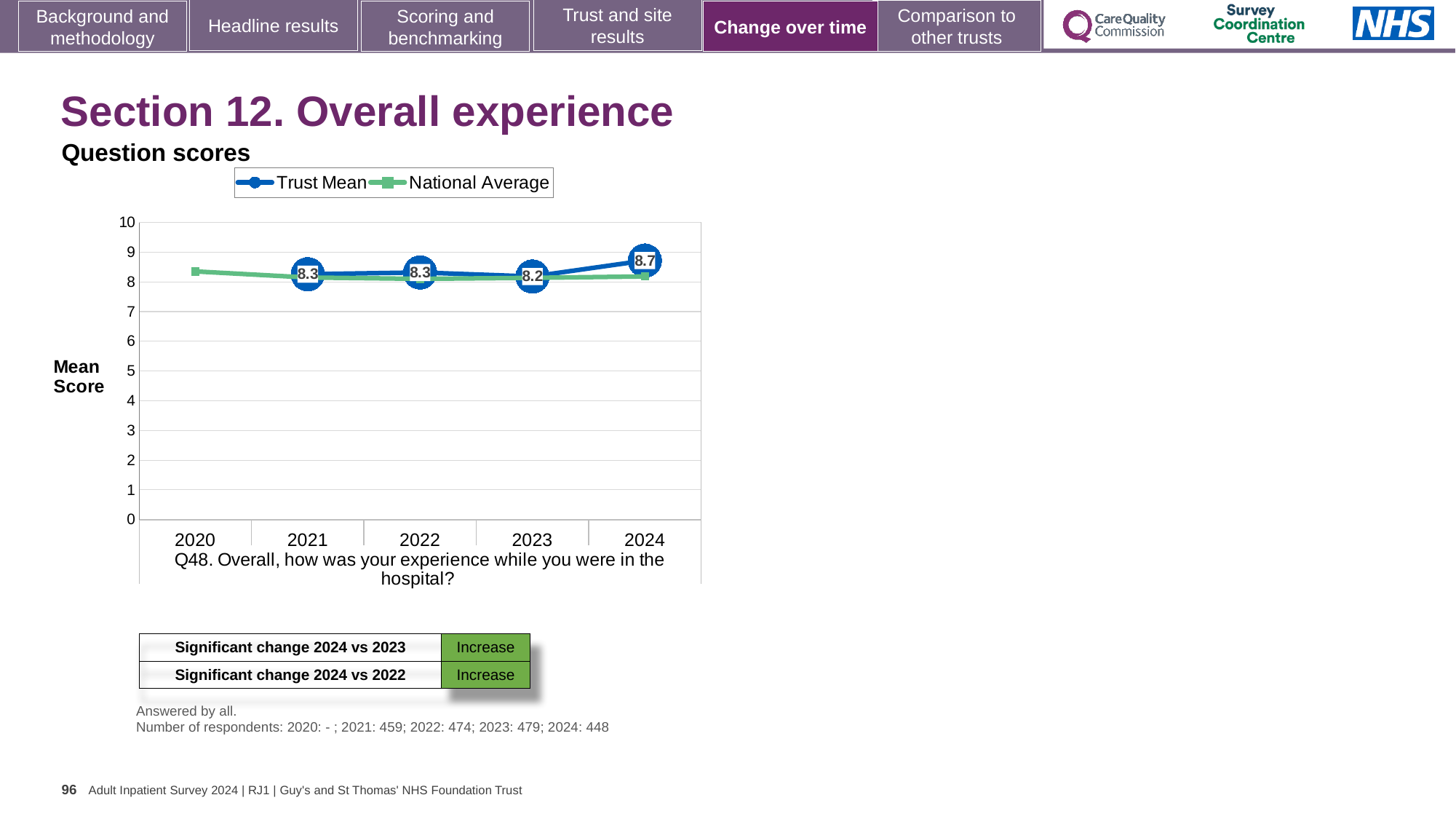
Does the Trust Mean score rise or fall from 2023 to 2024? Rise Is the National Average value for 2020 greater or less than 7? greater What is the Trust Mean score for 2024? 8.7 What is the Trust Mean score for 2021? 8.3 In which year is the Trust Mean score lowest? 2023 How many years are shown on the x axis? 5 What is the Trust Mean score for 2023? 8.2 Which is larger, the Trust Mean score for 2024 or for 2022? 2024 In which year is the Trust Mean score highest? 2024 What kind of chart is shown on the slide? Line chart How many series does the legend list? 2 What is the difference between the Trust Mean scores for 2024 and 2023? 0.5